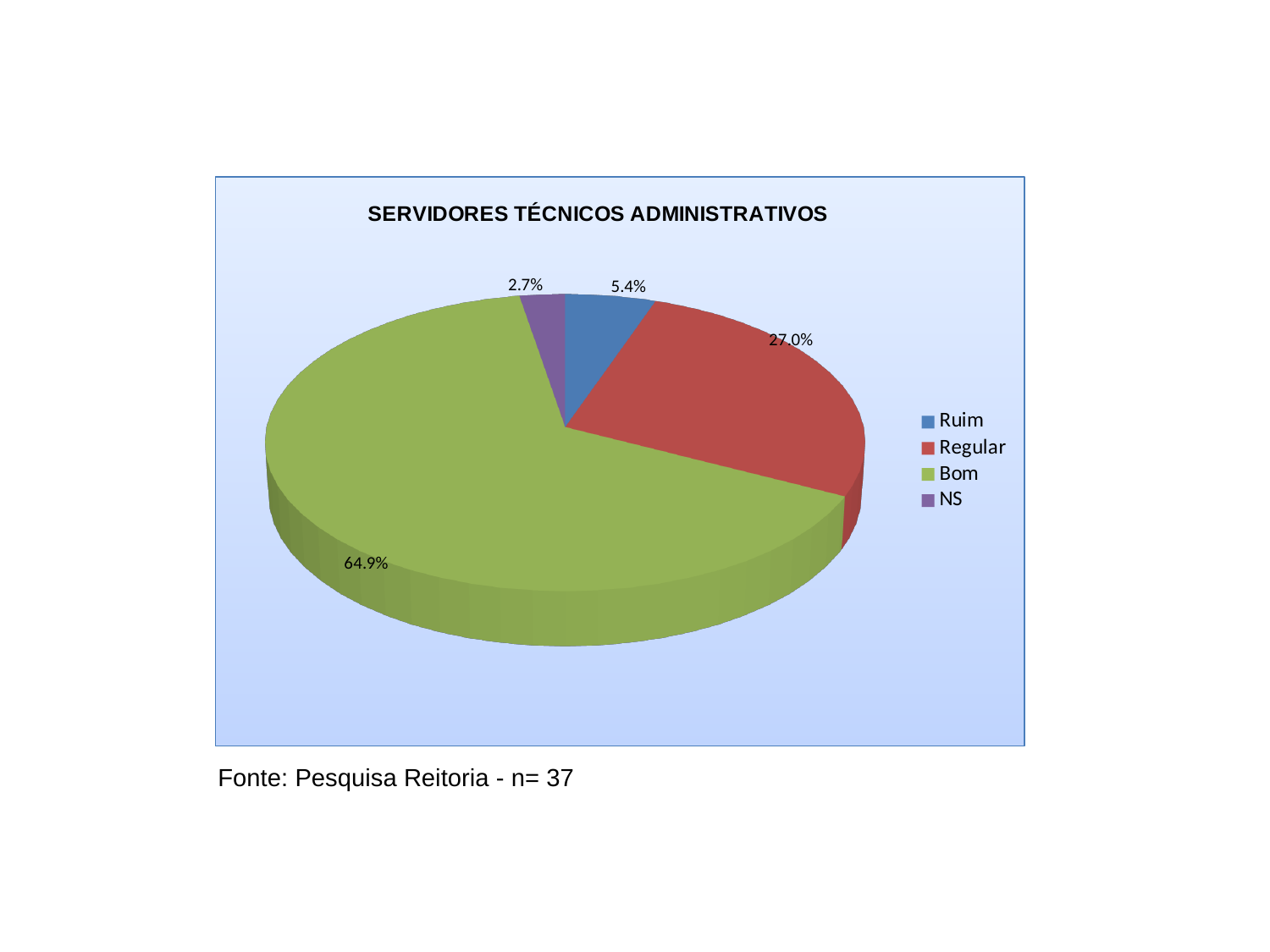
Which category has the largest slice of the pie? Bom What colour is the slice for Regular? Red What is the difference in percentage points between Bom and Regular? 37.9 Which category has the smallest slice of the pie? NS What type of chart is shown on the slide? Pie chart What is the title of the chart? SERVIDORES TÉCNICOS ADMINISTRATIVOS What percentage of the pie is labelled for NS? 2.7% What percentage of the pie is labelled for Ruim? 5.4% Which slice is larger, Ruim or Regular? Regular What percentage of the pie is labelled for Bom? 64.9% What percentage of the pie is labelled for Regular? 27.0% How many categories does the legend list? 4